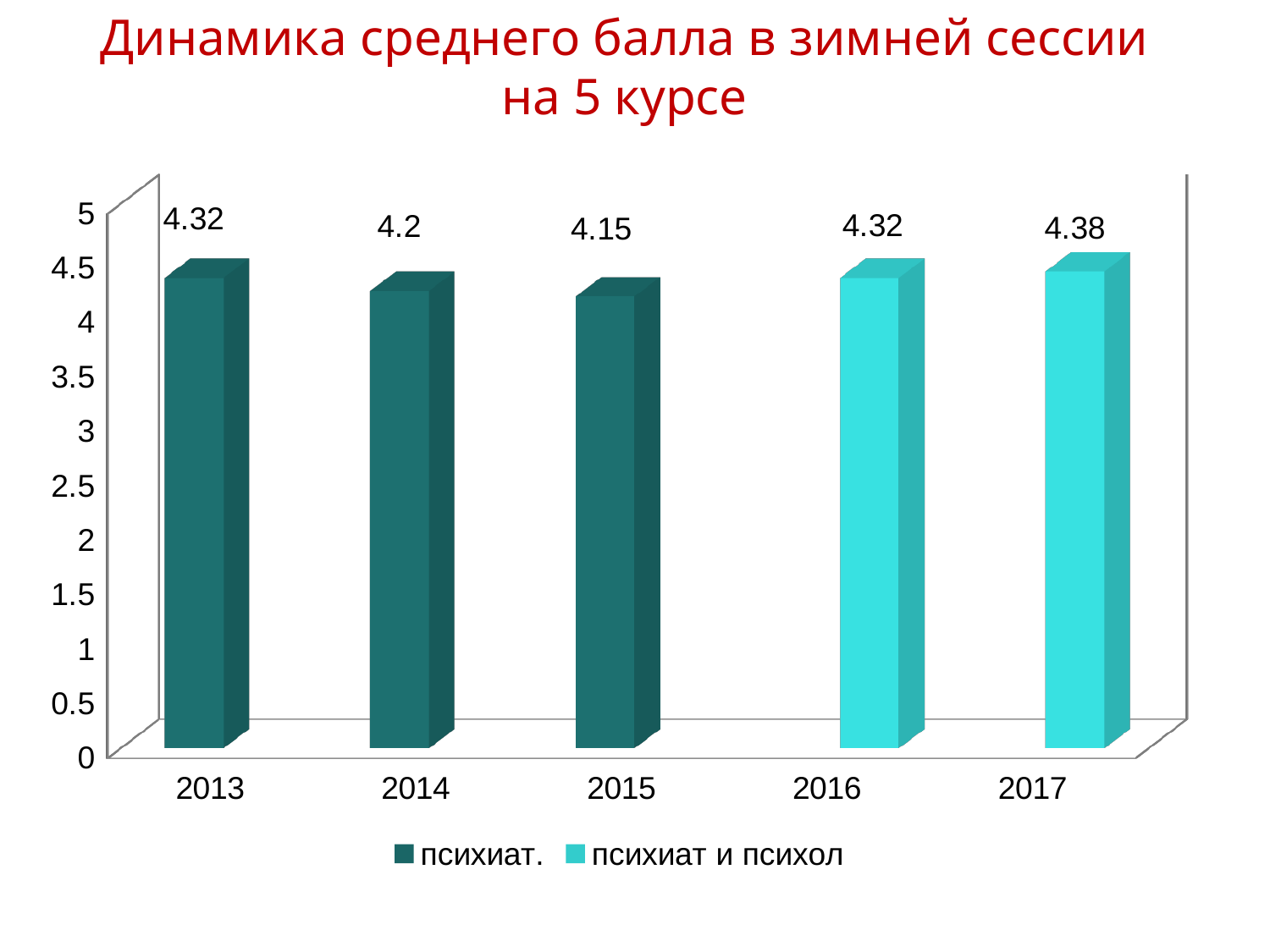
What kind of chart is shown on the slide? bar chart How many series does the legend list? 2 Which year has the highest average score? 2017 Which legend entry corresponds to the bars for 2016 and 2017? психиат и психол Which year has the lowest average score? 2015 What is the average score shown for 2013? 4.32 Is the value for 2014 greater or less than 4? greater What is the average score shown for 2015? 4.15 What is the average score shown for 2017? 4.38 How many years are shown on the x axis? 5 What is the difference between the average score in 2017 and in 2015? 0.23 Which year has a higher average score, 2014 or 2016? 2016